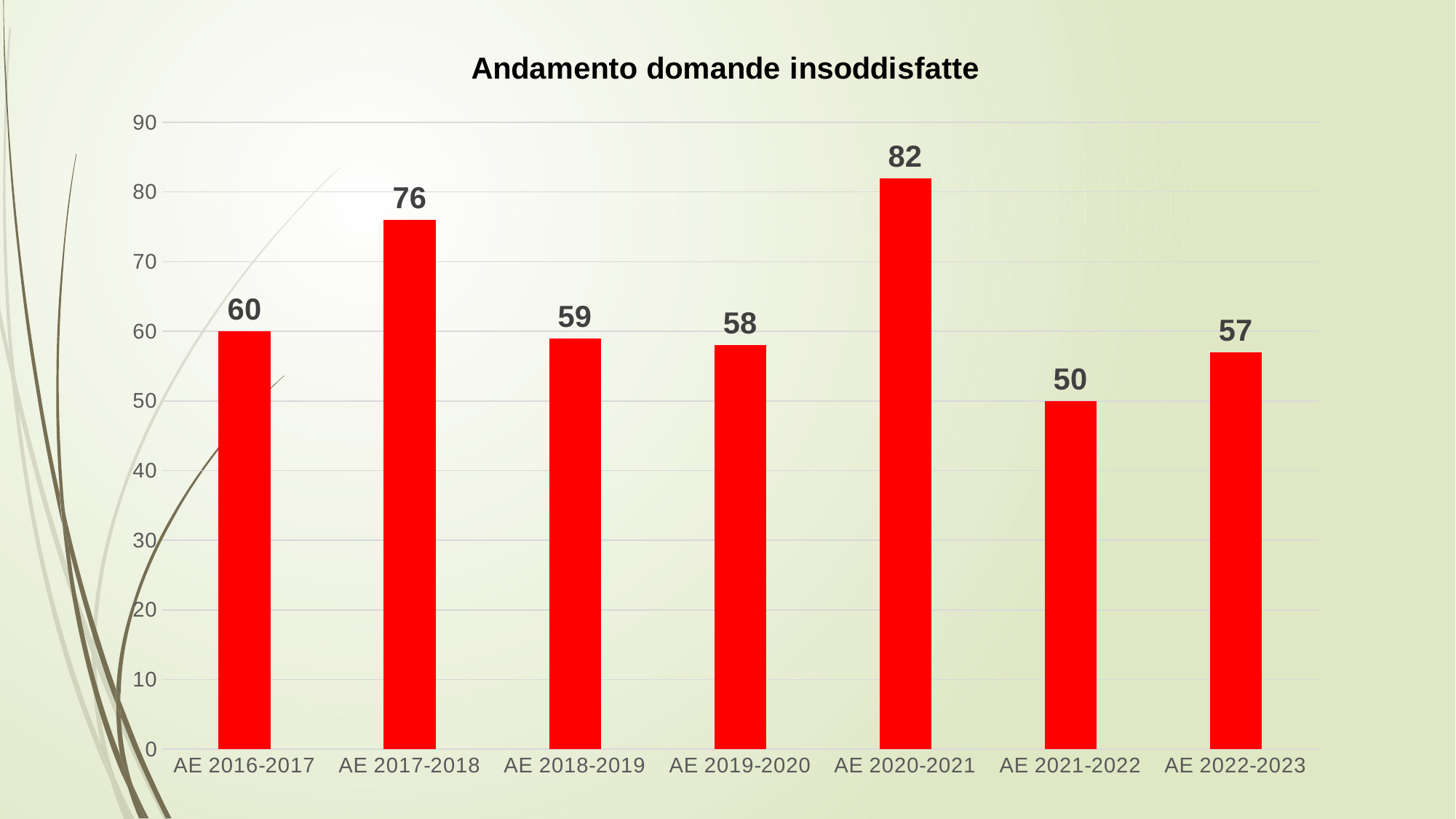
What is the difference between the values for AE 2017-2018 and AE 2016-2017? 16 What is the value for AE 2022-2023? 57 Is the value for AE 2021-2022 greater or less than 60? less Which category has the highest value? AE 2020-2021 How many categories are shown on the x axis? 7 What kind of chart is shown on the slide? bar chart What is the difference between the values for AE 2020-2021 and AE 2021-2022? 32 What is the title of the chart? Andamento domande insoddisfatte Which is larger, the value for AE 2017-2018 or the value for AE 2018-2019? AE 2017-2018 Which category has the lowest value? AE 2021-2022 What is the value for AE 2016-2017? 60 What is the value for AE 2020-2021? 82